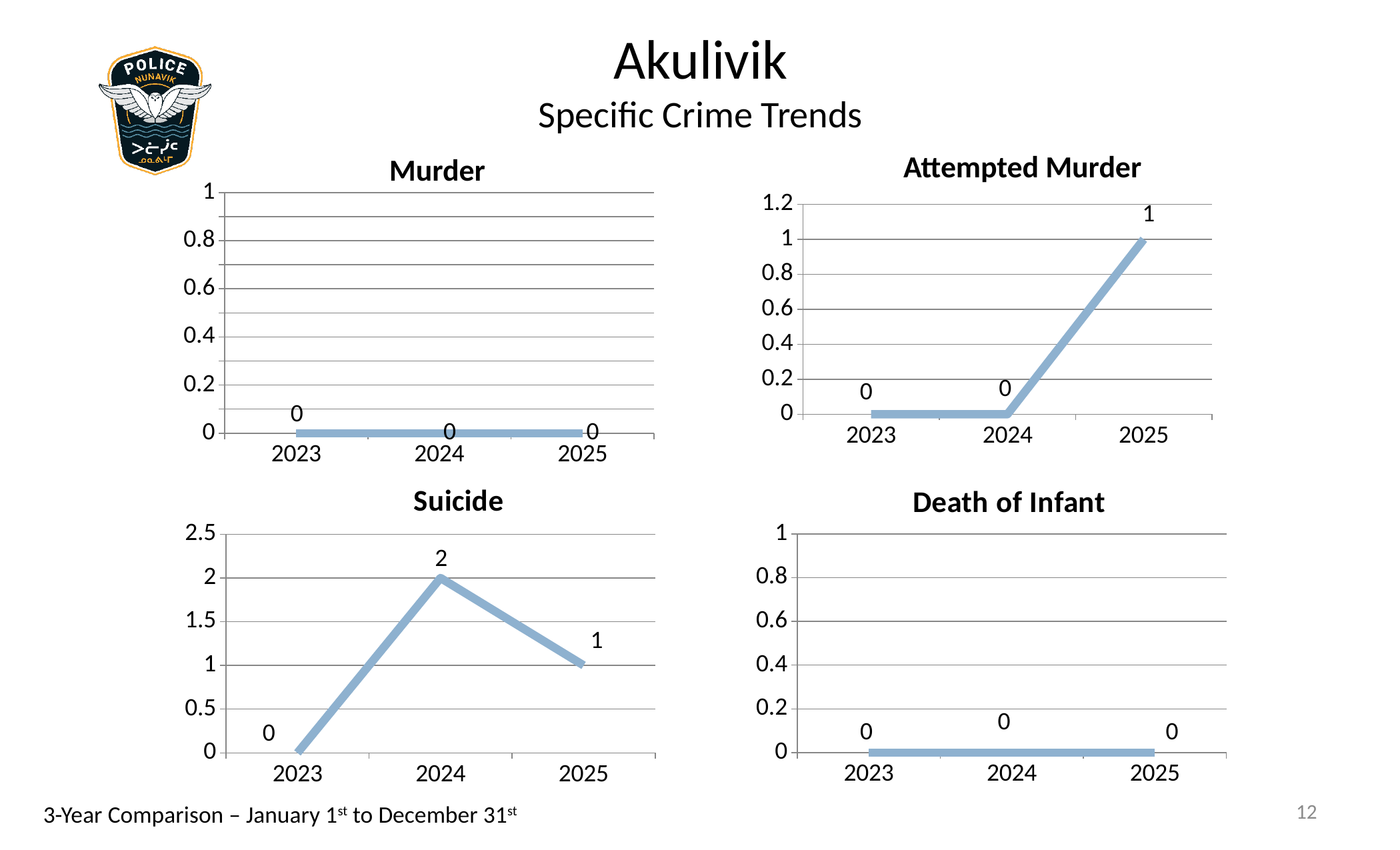
In the Murder chart, what is the value for 2024? 0 In the Attempted Murder chart, what is the value for 2025? 1 What is the title of the chart in the bottom right of the slide? Death of Infant In the Suicide chart, what is the value for 2025? 1 In the Attempted Murder chart, which is larger, the value for 2024 or the value for 2025? 2025 In the Suicide chart, which year has the highest value? 2024 What kind of chart is the Suicide chart? line chart How many years are plotted in the Death of Infant chart? 3 In the Attempted Murder chart, do the values rise or fall from 2024 to 2025? rise In the Suicide chart, what is the difference between the values for 2024 and 2025? 1 In the Suicide chart, what is the value for 2024? 2 In the Suicide chart, which year has the lowest value? 2023